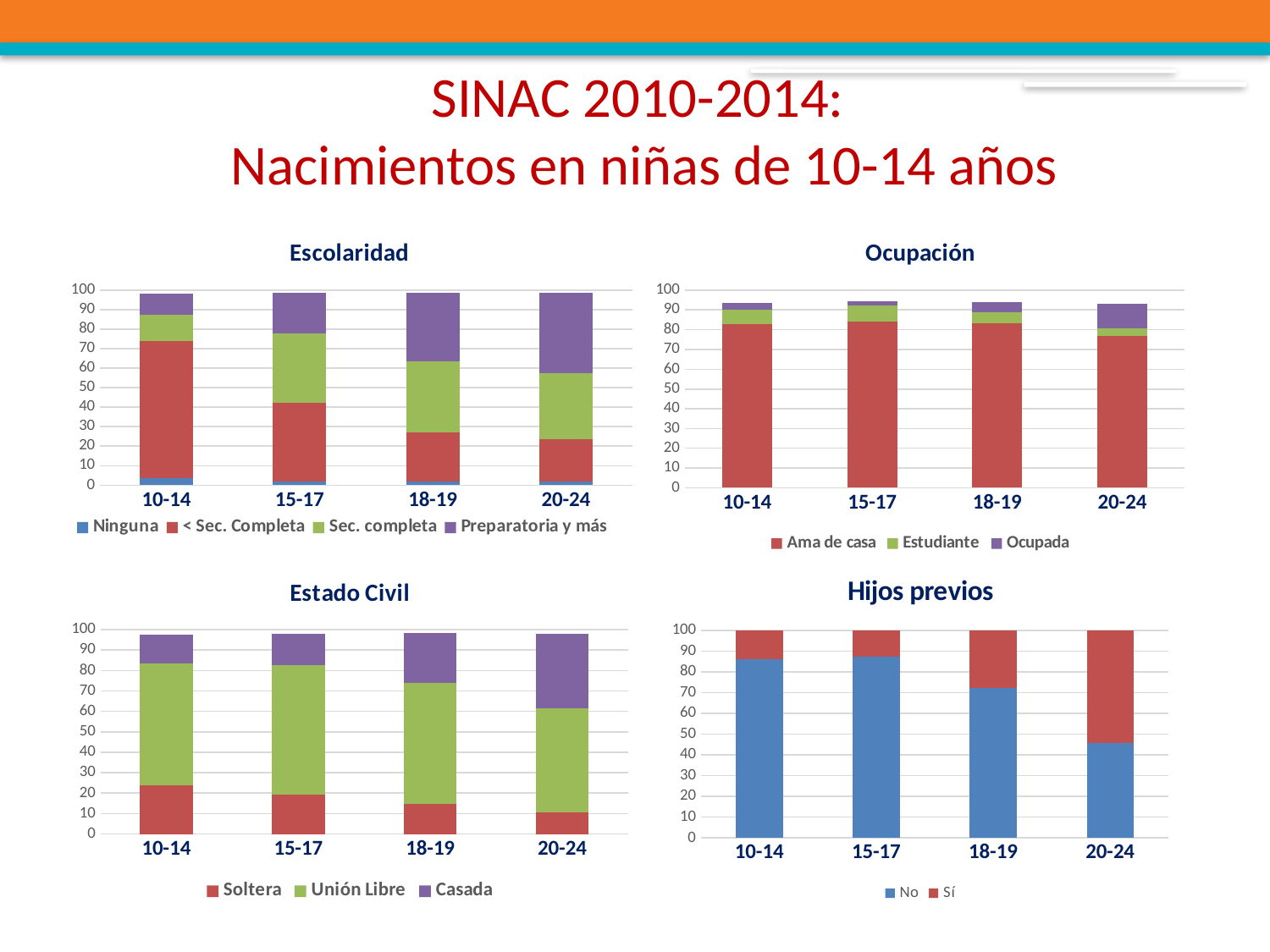
In the Escolaridad chart, which age group has the largest 'Preparatoria y más' segment? 20-24 In the Escolaridad chart, which age group has the largest '< Sec. Completa' segment? 10-14 What kind of chart is the Escolaridad chart? stacked bar chart In the Estado Civil chart, which age group has the largest 'Casada' segment? 20-24 In the Hijos previos chart, is the 'No' value for 20-24 greater or less than 50? less How many age groups are shown on the x axis of the Hijos previos chart? 4 In the Escolaridad chart, does the '< Sec. Completa' share rise or fall as the age groups go from 10-14 to 20-24? fall In the Hijos previos chart, is the 'No' value larger for 10-14 or for 20-24? 10-14 How many series does the legend of the Ocupación chart list? 3 How many series does the legend of the Hijos previos chart list? 2 How many series does the legend of the Escolaridad chart list? 4